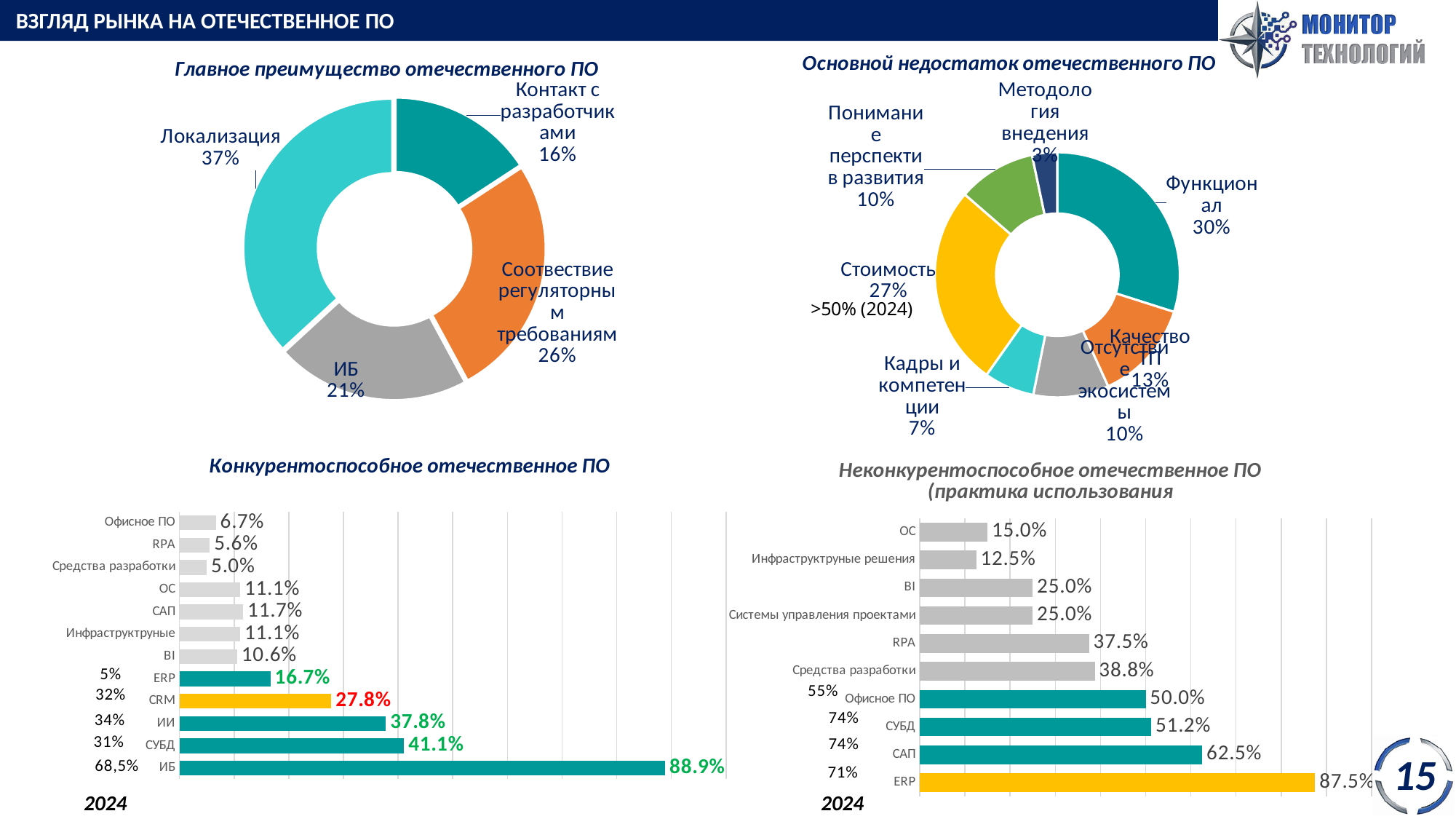
What type of chart is 'Основной недостаток отечественного ПО'? Donut (pie) chart In the chart 'Конкурентоспособное отечественное ПО', how many categories are shown? 12 In the chart 'Неконкурентоспособное отечественное ПО (практика использования)', what is the value for САП? 62.5% In the chart 'Главное преимущество отечественного ПО', what share does Локализация have? 37% In the chart 'Основной недостаток отечественного ПО', which is larger: Стоимость or Качество? Стоимость In the chart 'Основной недостаток отечественного ПО', what share does Функционал have? 30% In the chart 'Главное преимущество отечественного ПО', what is the difference between Локализация and ИБ? 16% In the chart 'Главное преимущество отечественного ПО', which category has the smallest share? Контакт с разработчиками In the chart 'Конкурентоспособное отечественное ПО', what is the value for ИБ? 88.9% In the chart 'Конкурентоспособное отечественное ПО', what is the difference between СУБД and ИИ? 3.3% In the chart 'Неконкурентоспособное отечественное ПО (практика использования)', which category has the highest value? ERP In the chart 'Основной недостаток отечественного ПО', which category has the smallest share? Методология внедрения